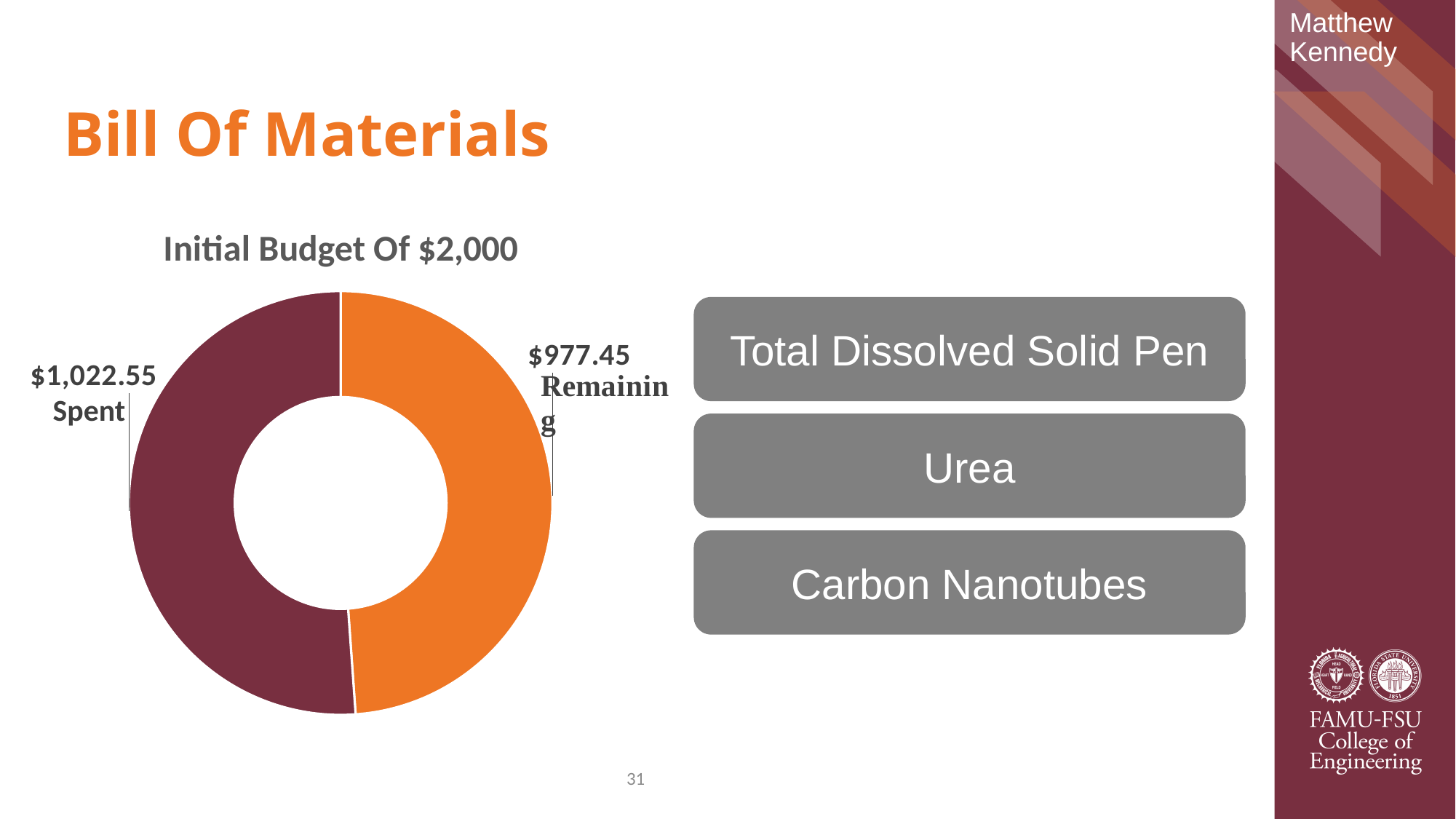
Is the Spent value in the Initial Budget Of $2,000 chart greater or less than $1,000? greater Which slice of the Initial Budget Of $2,000 chart is larger, Spent or Remaining? Spent Which category has the smallest value in the Initial Budget Of $2,000 chart? Remaining What is the title of the chart on the slide? Initial Budget Of $2,000 What colour is the Remaining slice in the Initial Budget Of $2,000 chart? orange What is the difference between the Spent and Remaining values in the Initial Budget Of $2,000 chart? $45.10 What is the value of the Spent slice in the Initial Budget Of $2,000 chart? $1,022.55 What is the value of the Remaining slice in the Initial Budget Of $2,000 chart? $977.45 How many slices does the Initial Budget Of $2,000 chart have? 2 What is the total of the Spent and Remaining slices in the Initial Budget Of $2,000 chart? $2,000.00 Which category has the largest value in the Initial Budget Of $2,000 chart? Spent What kind of chart is used to show the Initial Budget Of $2,000? doughnut chart